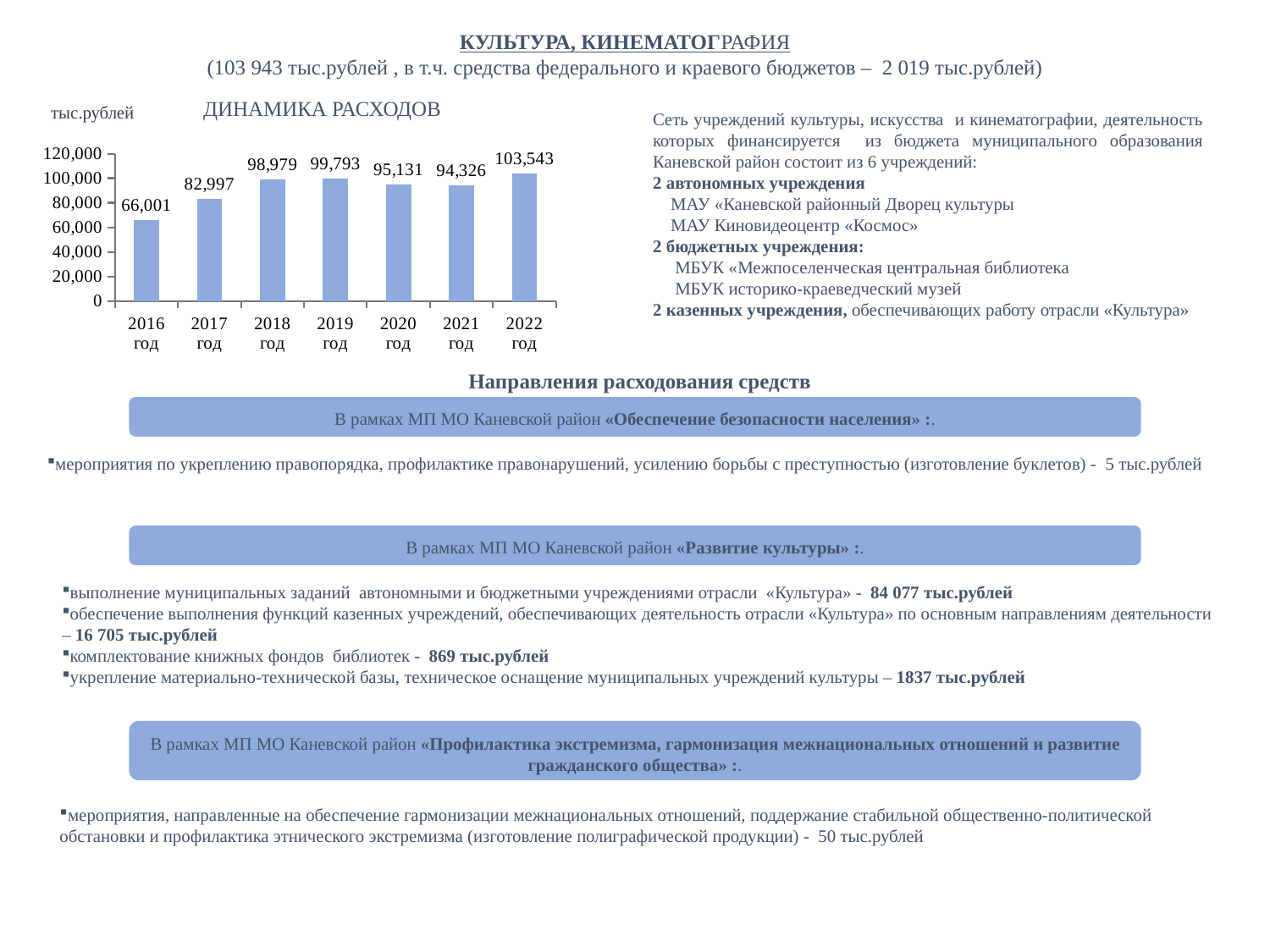
Is the value for 2017 год in the ДИНАМИКА РАСХОДОВ chart greater or less than 100,000? less What is the value for 2020 год in the ДИНАМИКА РАСХОДОВ chart? 95,131 How many years are shown in the ДИНАМИКА РАСХОДОВ chart? 7 What is the difference between the values for 2018 год and 2017 год in the ДИНАМИКА РАСХОДОВ chart? 15,982 What is the difference between the values for 2022 год and 2016 год in the ДИНАМИКА РАСХОДОВ chart? 37,542 Which year has the highest value in the ДИНАМИКА РАСХОДОВ chart? 2022 год What kind of chart is the ДИНАМИКА РАСХОДОВ chart? bar chart What is the value for 2022 год in the ДИНАМИКА РАСХОДОВ chart? 103,543 In the ДИНАМИКА РАСХОДОВ chart, which is larger: the value for 2019 год or the value for 2021 год? 2019 год What is the value for 2016 год in the ДИНАМИКА РАСХОДОВ chart? 66,001 Which year has the lowest value in the ДИНАМИКА РАСХОДОВ chart? 2016 год What unit is indicated for the values in the ДИНАМИКА РАСХОДОВ chart? тыс.рублей